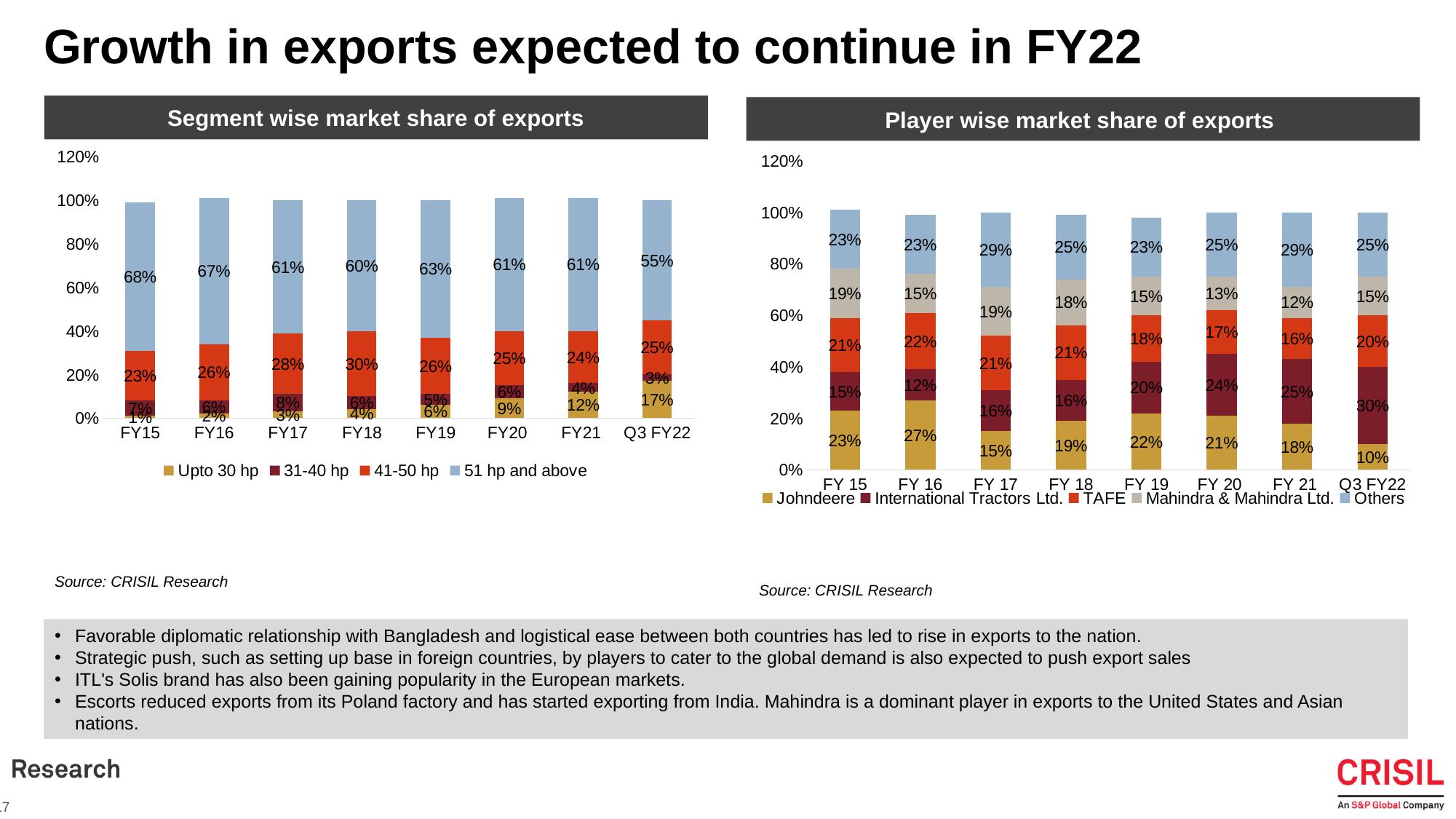
How many series does the legend of the 'Segment wise market share of exports' chart list? 4 In the 'Segment wise market share of exports' chart, what is the share of the Upto 30 hp segment in Q3 FY22? 17% In the 'Segment wise market share of exports' chart, does the Upto 30 hp share rise or fall from FY15 to Q3 FY22? rise In the 'Segment wise market share of exports' chart, which year has the highest share for the 41-50 hp segment? FY18 In the 'Segment wise market share of exports' chart, what is the share of the 51 hp and above segment in FY15? 68% How many fiscal periods are shown on the x axis of the 'Player wise market share of exports' chart? 8 What type of chart is the 'Player wise market share of exports' chart? Stacked bar chart In the 'Segment wise market share of exports' chart, what is the difference between the 51 hp and above share in FY15 and in Q3 FY22? 13 percentage points In the 'Player wise market share of exports' chart, which year has the lowest Johndeere share? Q3 FY22 In the 'Player wise market share of exports' chart, what is Johndeere's share in FY 16? 27% In the 'Player wise market share of exports' chart, which is larger in FY 20: the share of International Tractors Ltd. or TAFE? International Tractors Ltd. In the 'Player wise market share of exports' chart, what is the share of International Tractors Ltd. in Q3 FY22? 30%